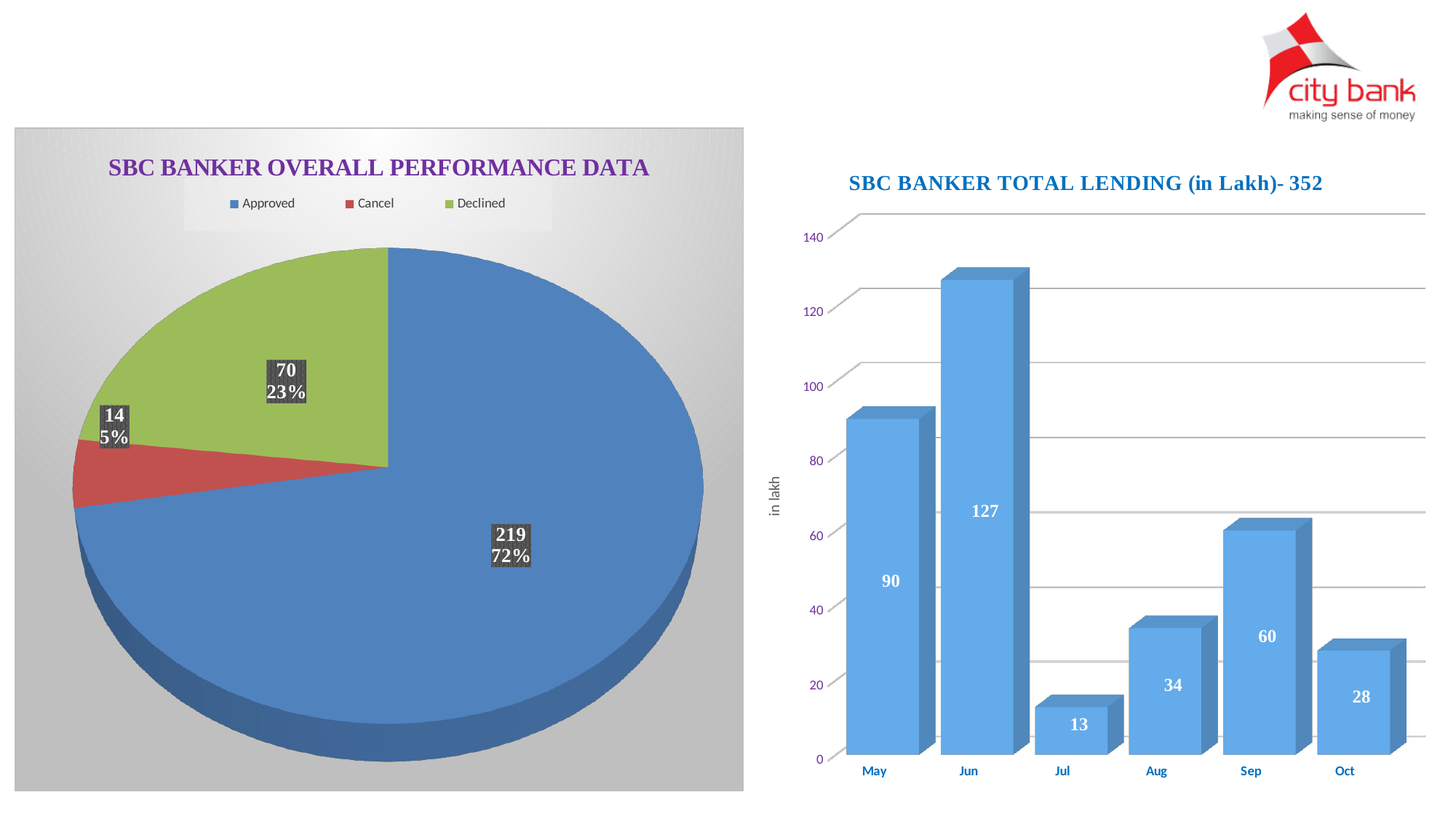
In the SBC BANKER TOTAL LENDING chart, how many months are plotted? 6 In the SBC BANKER OVERALL PERFORMANCE DATA chart, what share of the pie is Declined? 23% In the SBC BANKER OVERALL PERFORMANCE DATA chart, which category has the smallest slice? Cancel What kind of chart is SBC BANKER OVERALL PERFORMANCE DATA? Pie chart What kind of chart is SBC BANKER TOTAL LENDING? Bar chart In the SBC BANKER TOTAL LENDING chart, which is larger, Aug or Oct? Aug In the SBC BANKER TOTAL LENDING chart, what is the difference between May and Sep? 30 In the SBC BANKER OVERALL PERFORMANCE DATA chart, what is the difference between the Declined and Cancel values? 56 In the SBC BANKER TOTAL LENDING chart, which month has the lowest value? Jul In the SBC BANKER OVERALL PERFORMANCE DATA chart, what is the value for Approved? 219 In the SBC BANKER TOTAL LENDING chart, what is the value for Jun? 127 In the SBC BANKER OVERALL PERFORMANCE DATA chart, how many categories does the legend list? 3